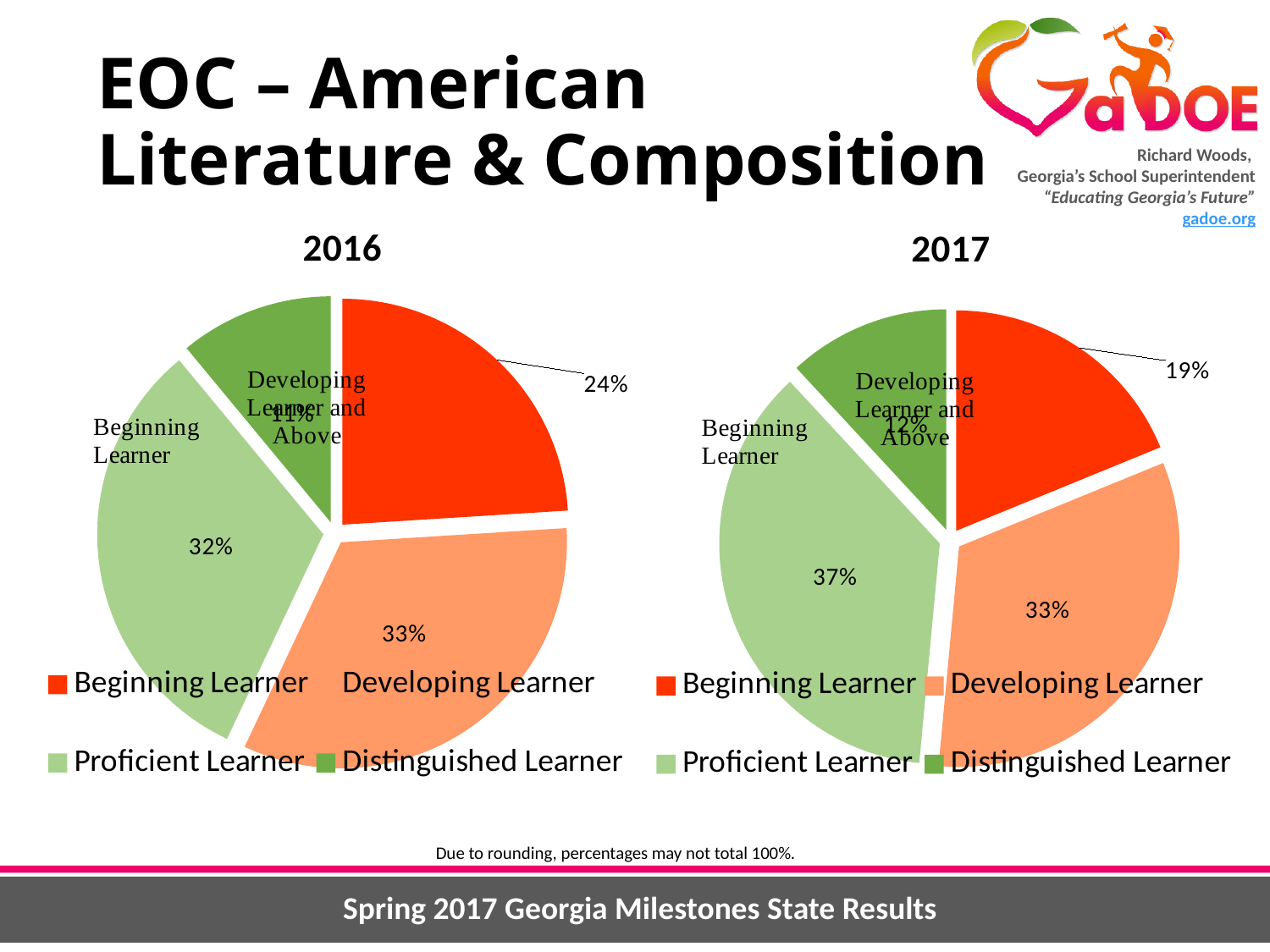
In the 2016 pie chart, what percentage is shown for Beginning Learner? 24% In the 2017 pie chart, what percentage is shown for Proficient Learner? 37% What type of chart is used to show the 2016 results? Pie chart How many slices does the 2017 pie chart have? 4 In the 2016 pie chart, what percentage is shown for Distinguished Learner? 11% In the 2017 pie chart, which category has the smallest share? Distinguished Learner In the 2017 pie chart, which category has the largest share? Proficient Learner What is the difference between the Beginning Learner percentages in the 2016 and 2017 pie charts? 5% How many entries does the legend of the 2016 chart list? 4 In the 2017 pie chart, what percentage is shown for Beginning Learner? 19% In the 2016 pie chart, which category has the largest share? Developing Learner Is the Proficient Learner share larger in the 2016 pie chart or the 2017 pie chart? 2017